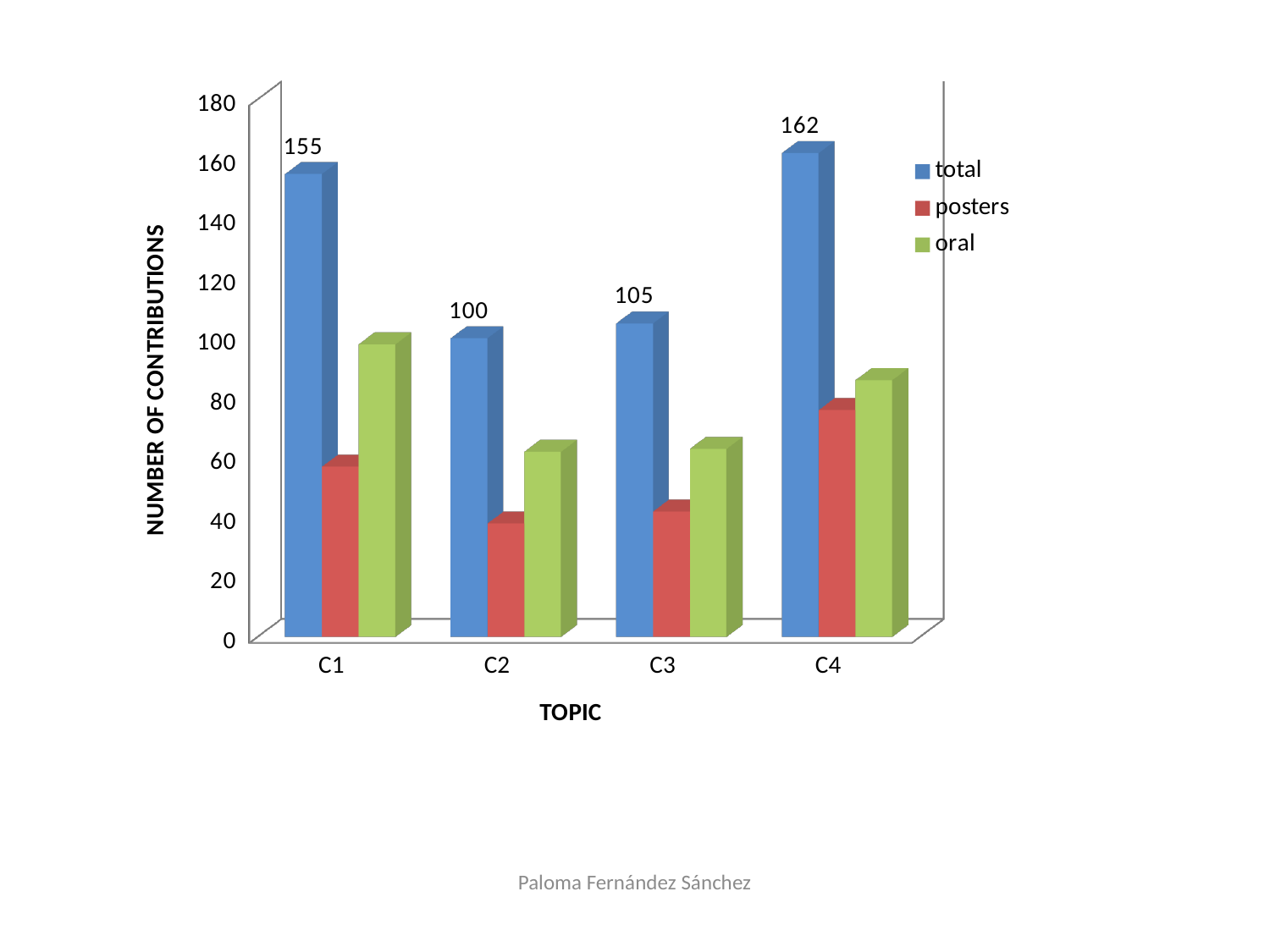
How many series does the legend list? 3 Is the value for posters in topic C2 greater or less than 60? less How many topics are shown on the x axis? 4 Is the value for posters in topic C4 greater or less than 60? greater What is the total number of contributions for topic C1? 155 What is the difference between the total contributions for C3 and C2? 5 In topic C1, which is larger, the oral or the posters value? oral What is the difference between the total contributions for C4 and C1? 7 Which topic has the highest total number of contributions? C4 Which topic has the lowest total number of contributions? C2 Is the value for oral in topic C4 greater or less than 100? less What is the total number of contributions for topic C4? 162